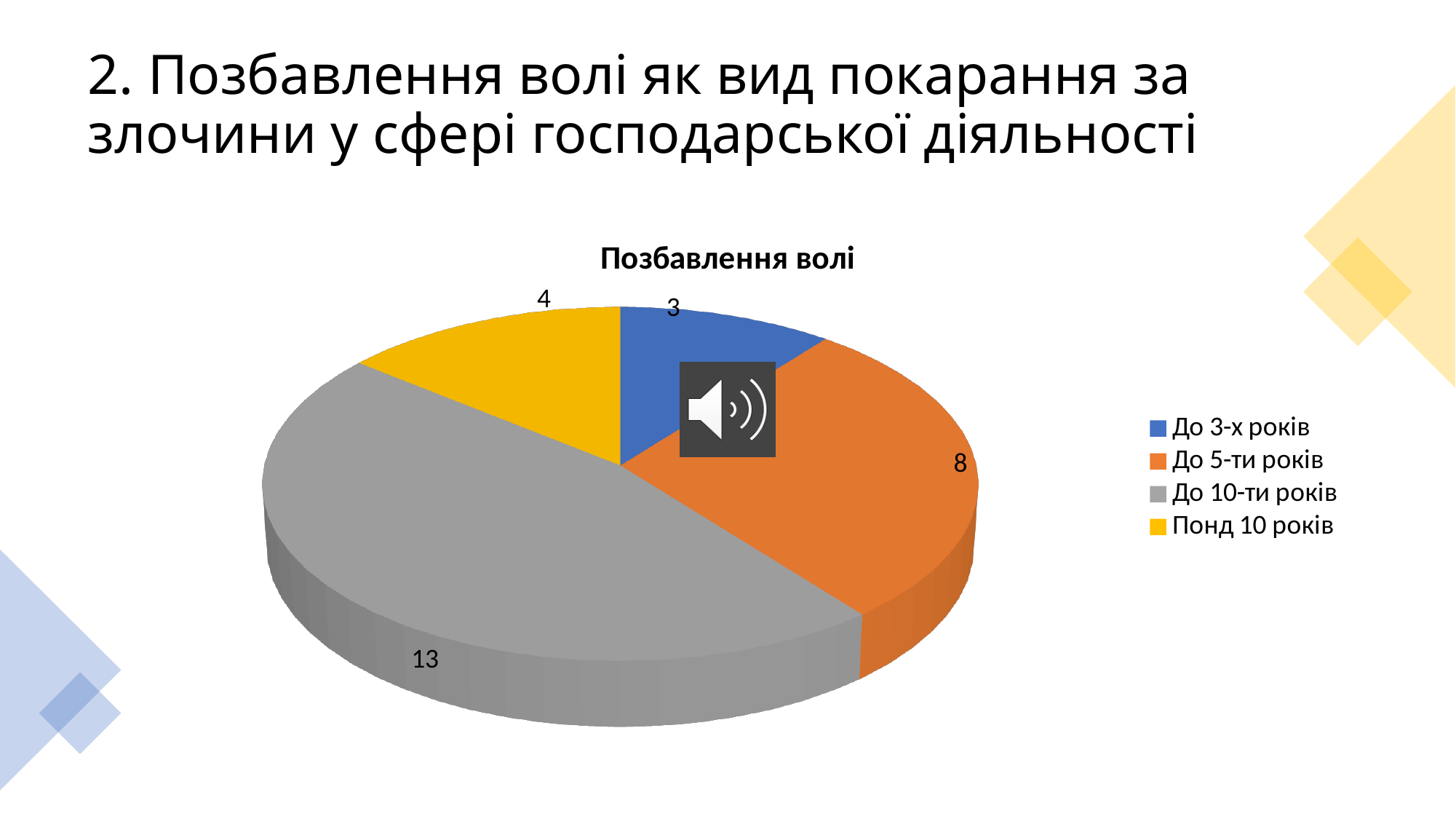
Which is larger, the value for "Понд 10 років" or the value for "До 3-х років"? Понд 10 років Which category has the largest slice? До 10-ти років How many slices does the pie chart have? 4 What is the value for "Понд 10 років"? 4 How many entries does the legend list? 4 What is the value for "До 5-ти років"? 8 What is the value for "До 10-ти років"? 13 What is the title of the chart? Позбавлення волі Which category has the smallest slice? До 3-х років What is the value for "До 3-х років"? 3 What type of chart is shown on the slide? pie chart What is the difference between the values for "До 10-ти років" and "До 5-ти років"? 5